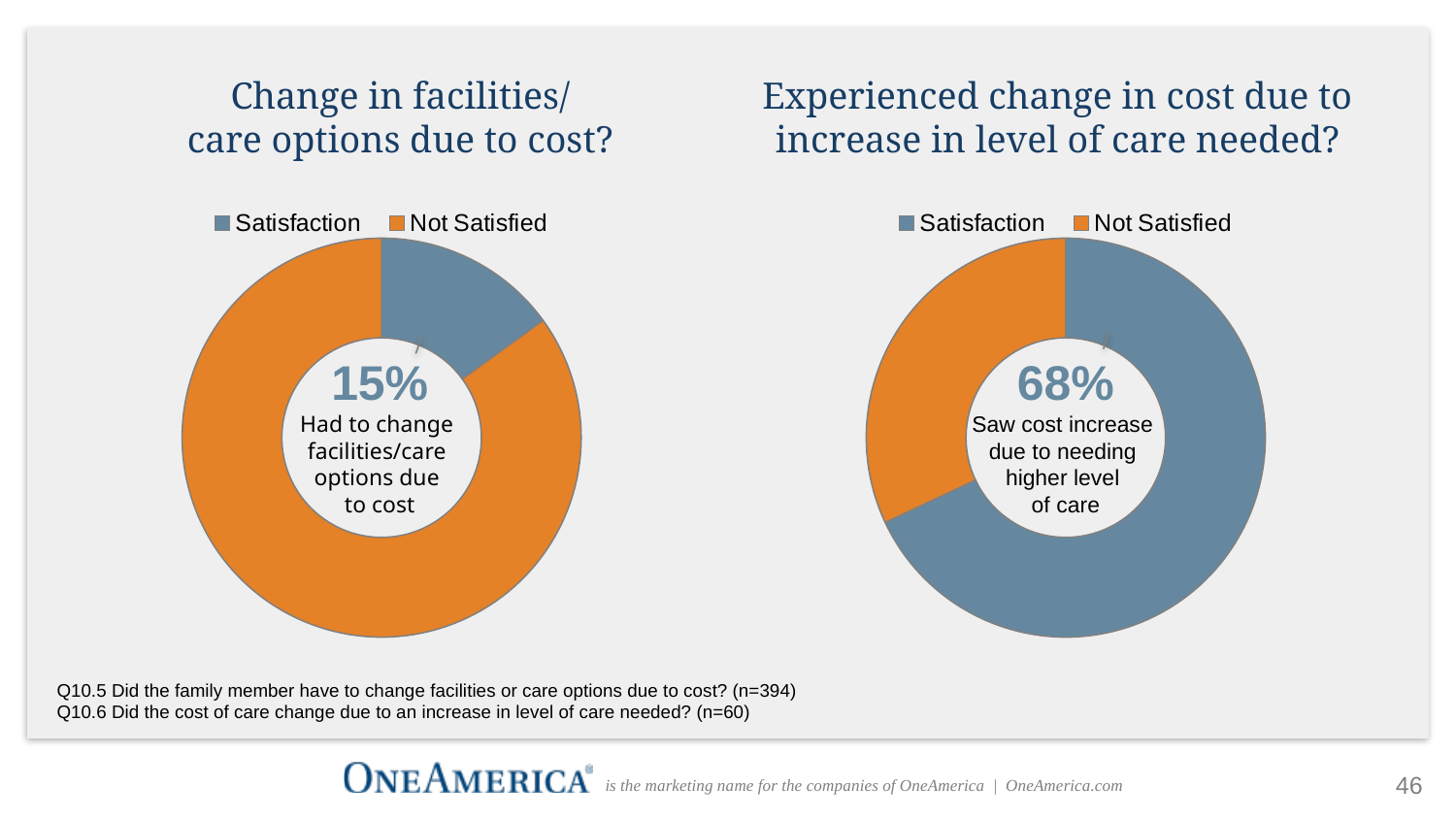
What colour represents 'Not Satisfied' in the legends? orange In the right chart, which slice is larger: Satisfaction or Not Satisfied? Satisfaction In the left chart, is the Satisfaction slice greater or less than half of the donut? less What is the title of the chart on the left of the slide? Change in facilities/ care options due to cost? How many entries does the legend of the left chart list? 2 How many slices does the right chart have? 2 Which chart shows the larger percentage in its centre, the left chart or the right chart? the right chart In the chart titled 'Change in facilities/care options due to cost?', what percentage is printed in the centre of the donut? 15% In the chart titled 'Experienced change in cost due to increase in level of care needed?', what percentage is printed in the centre of the donut? 68% What kind of chart is used on this slide? pie chart (donut) In the left chart, which slice is larger: Satisfaction or Not Satisfied? Not Satisfied What is the difference between the centre percentage of the right chart (68%) and the centre percentage of the left chart (15%)? 53 percentage points